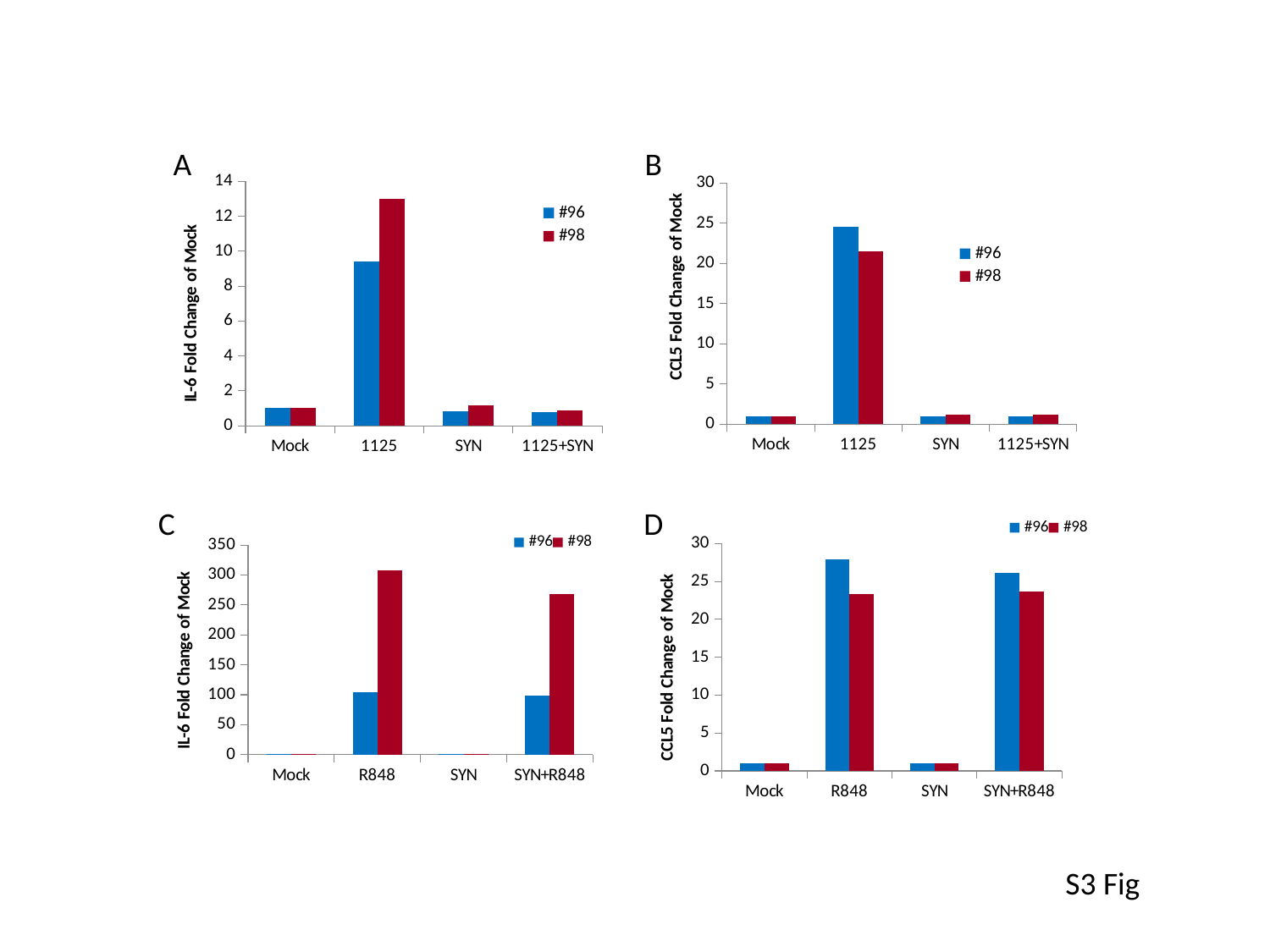
In chart A, which category has the highest IL-6 fold change? 1125 In chart D, is the #96 value for R848 greater or less than 25? greater What type of chart is chart D? bar chart In chart D, which series has the larger value for R848, #96 or #98? #96 How many series does the legend of chart B list? 2 In chart C, which is larger for series #98, R848 or SYN+R848? R848 In chart B, is the #96 value for 1125 greater or less than 20? greater In chart A, which series has the larger value for 1125, #96 or #98? #98 In chart C, is the #98 value for R848 greater or less than 250? greater How many categories are shown on the x axis of chart C? 4